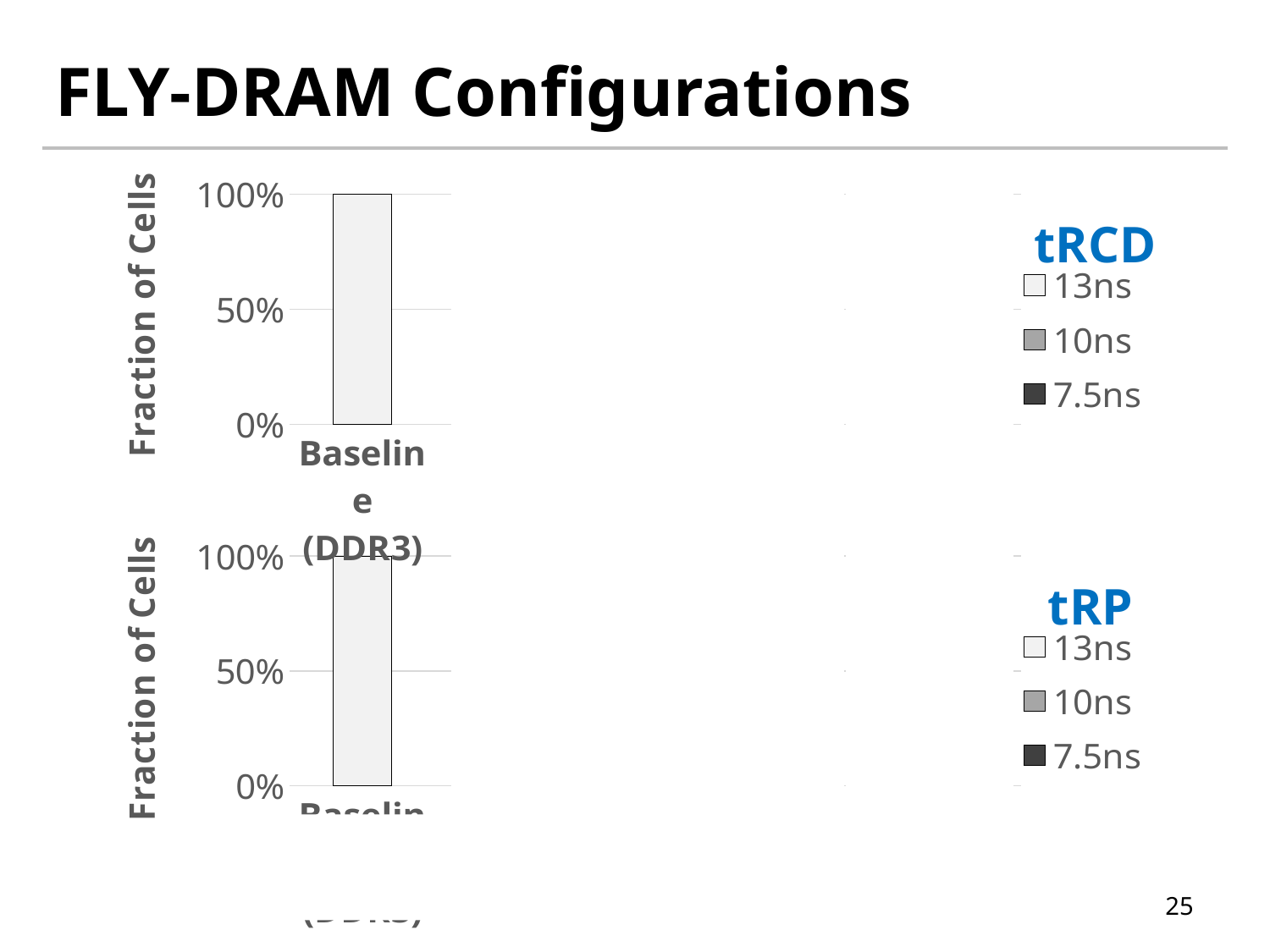
Which legend entries are listed for the bottom chart (tRP)? 13ns, 10ns, 7.5ns How many bars are plotted on the bottom chart (tRP)? 1 On the bottom chart (tRP), what value does the single bar reach? 100% What is the y-axis label of the top chart (tRCD)? Fraction of Cells How many series does the legend of the top chart (tRCD) list? 3 How many bars are plotted on the top chart (tRCD)? 1 How many series does the legend of the bottom chart (tRP) list? 3 What is the category label of the bar on the top chart (tRCD)? Baseline (DDR3) What kind of chart is the bottom chart (tRP)? bar chart On the top chart (tRCD), is the value for Baseline (DDR3) greater or less than 50%? greater On the top chart (tRCD), what value does the Baseline (DDR3) bar reach? 100% What kind of chart is the top chart (tRCD)? bar chart